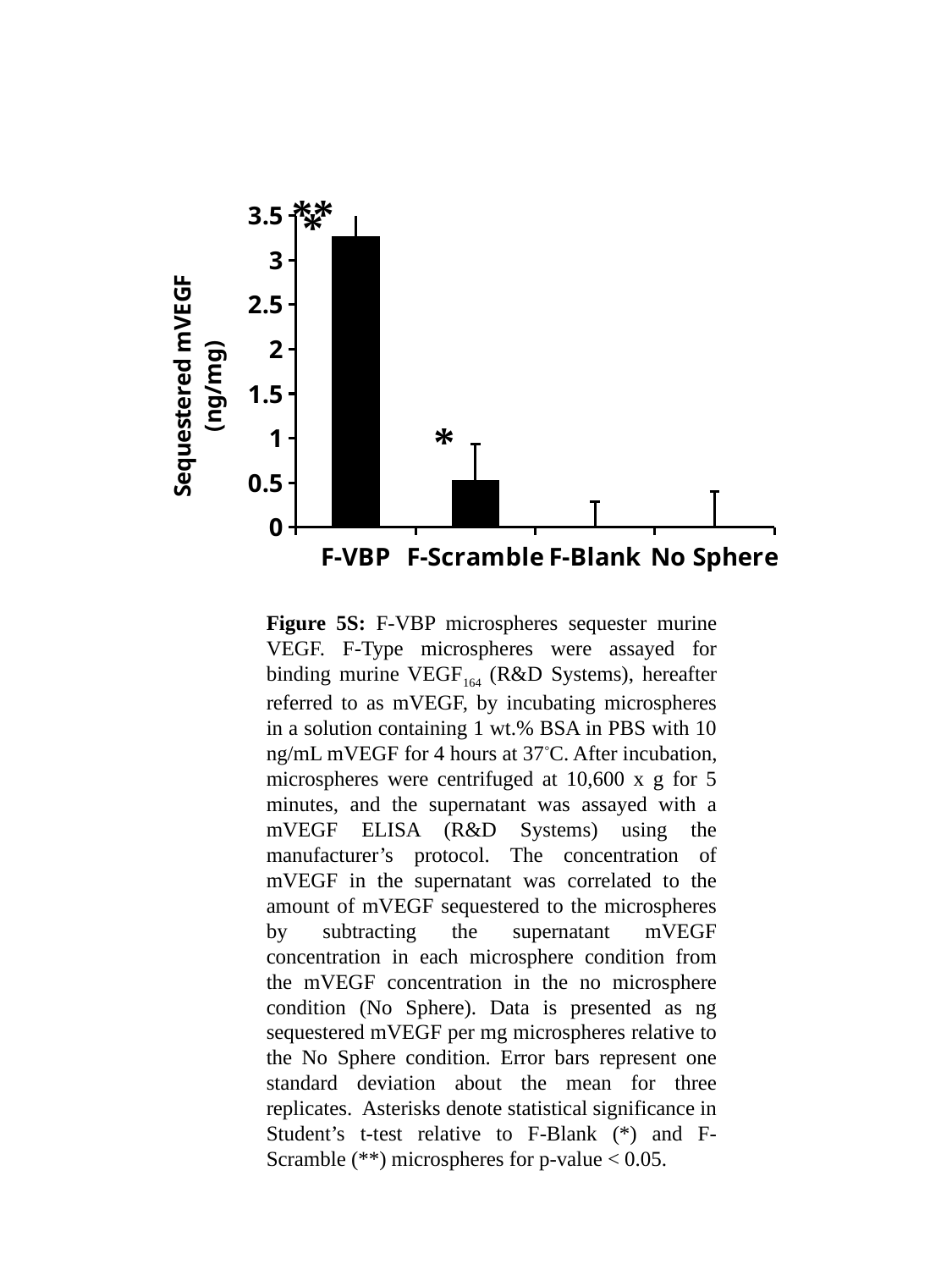
Is the value for F-Scramble greater or less than 1? less Do the bar values generally rise or fall from left to right along the x axis? fall How many categories are shown on the x axis of the chart? 4 Which is larger, the value for F-Scramble or the value for F-Blank? F-Scramble What kind of chart is shown on the slide? bar chart What is the highest tick value shown on the y axis? 3.5 Is the value for F-VBP greater or less than 3? greater Which category has the highest sequestered mVEGF value? F-VBP Which is larger, the value for F-VBP or the value for F-Scramble? F-VBP What is the label of the y axis of the chart? Sequestered mVEGF (ng/mg) Is the value for F-VBP greater or less than 3.5? less